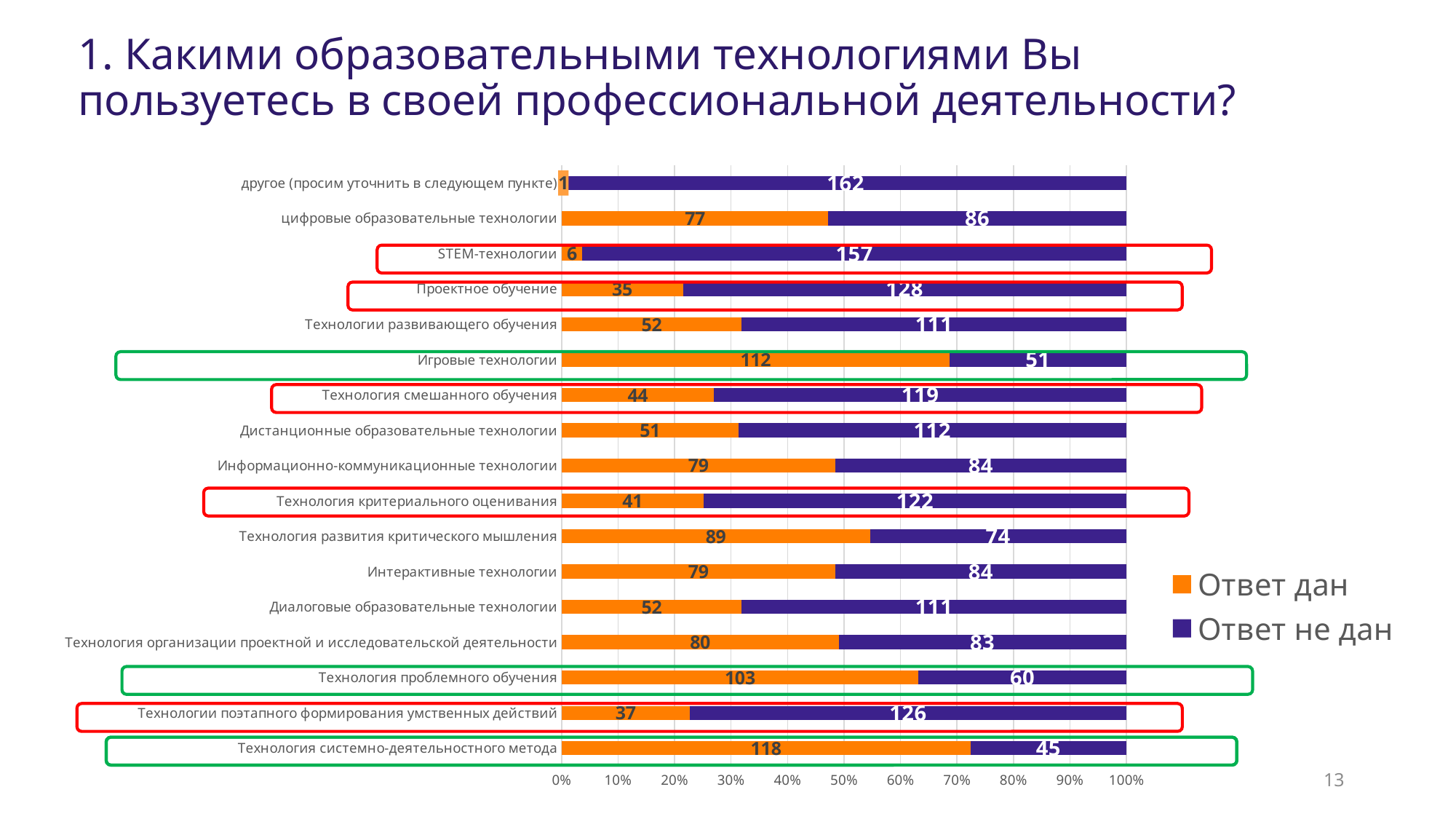
What is the difference between "Ответ не дан" and "Ответ дан" for "Проектное обучение"? 93 What is the total of the stacked bar for "Технология смешанного обучения"? 163 What is the value of "Ответ дан" for "Игровые технологии"? 112 What is the value of "Ответ дан" for "Технология проблемного обучения"? 103 Which category has the highest value for "Ответ дан"? Технология системно-деятельностного метода Which is larger for "Технология развития критического мышления": "Ответ дан" or "Ответ не дан"? Ответ дан What is the value of "Ответ не дан" for "STEM-технологии"? 157 Which category has the lowest value for "Ответ дан"? другое (просим уточнить в следующем пункте) What kind of chart is shown on the slide? Stacked bar chart Which category has the lowest value for "Ответ не дан"? Технология системно-деятельностного метода How many categories are plotted on the chart? 17 How many series does the legend list? 2